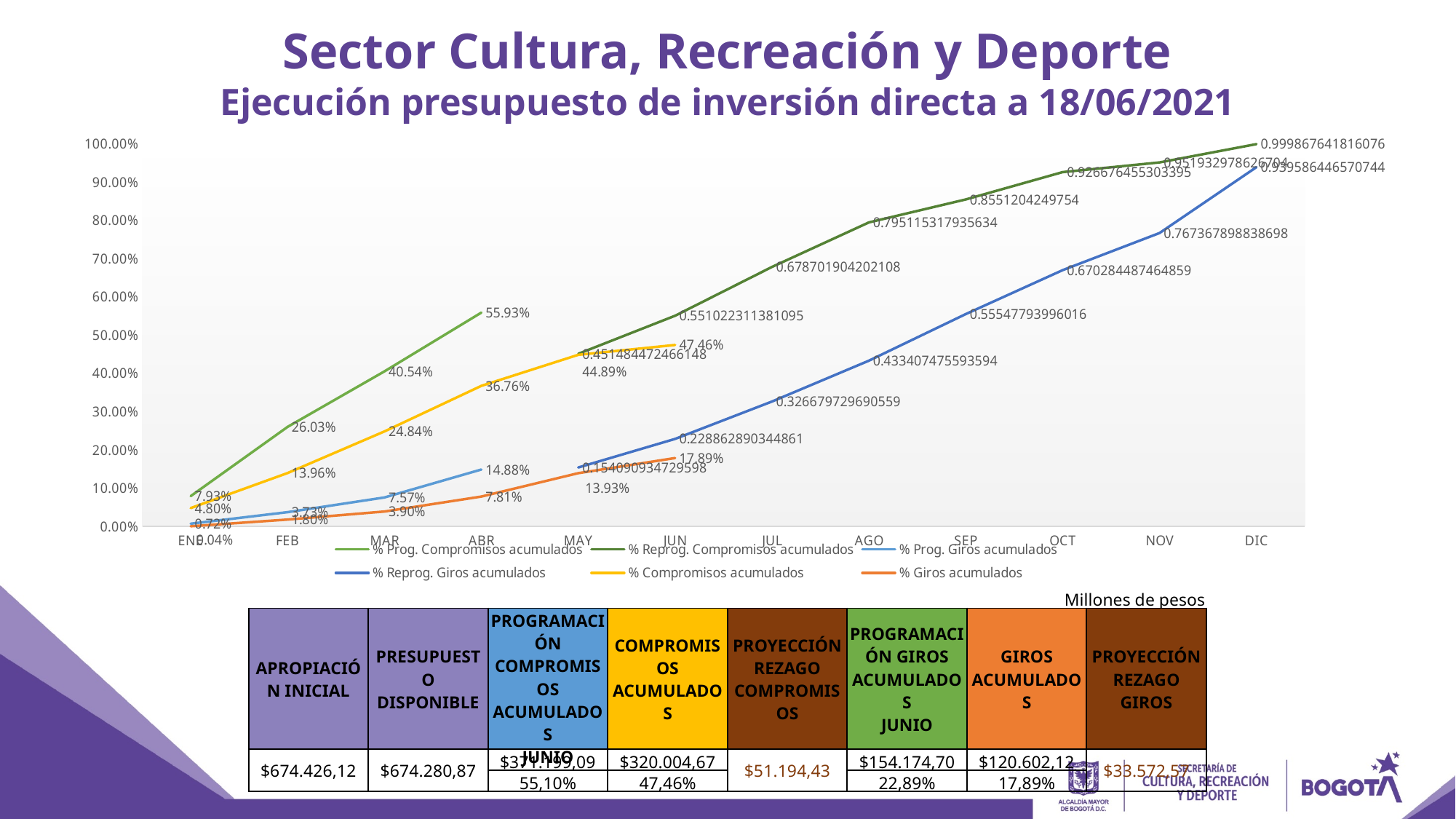
What is the value of % Reprog. Compromisos acumulados in DIC? 0.999867641816076 What is the value of % Prog. Compromisos acumulados in ABR? 55.93% By how much did % Compromisos acumulados increase from MAY to JUN? 2.57% What is the value of % Compromisos acumulados in JUN? 47.46% How many months are shown along the x axis of the chart? 12 How many series does the chart legend list? 6 In ABR, which is larger: % Prog. Compromisos acumulados or % Compromisos acumulados? % Prog. Compromisos acumulados What is the value of % Reprog. Giros acumulados in DIC? 0.939586446570744 What is the value of % Giros acumulados in JUN? 17.89% Does % Reprog. Giros acumulados rise or fall from MAY to DIC? rise What kind of chart is shown on the slide? line chart What is the value of % Prog. Giros acumulados in MAR? 7.57%